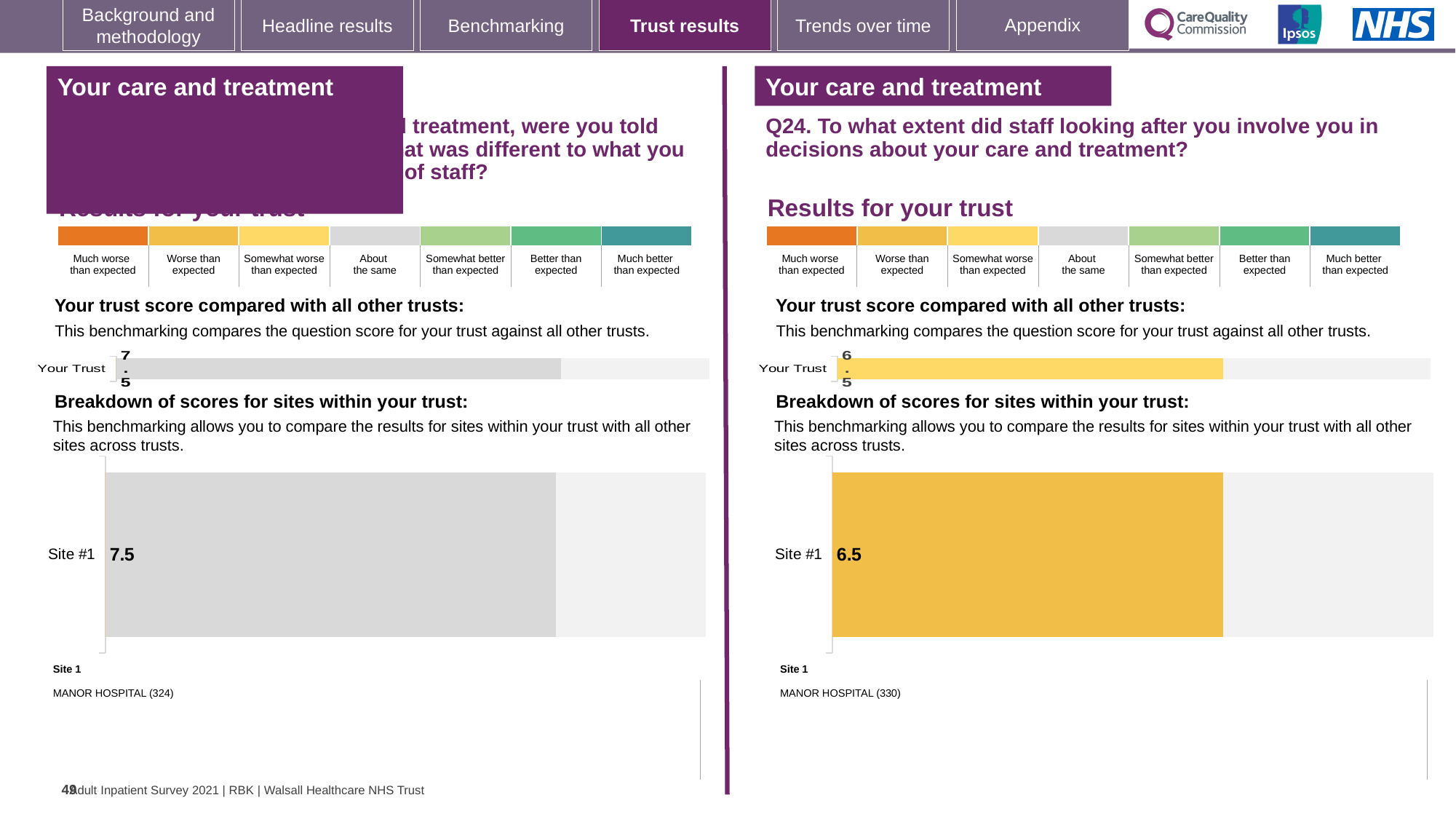
What kind of chart is used for the site breakdown on the left panel? bar chart On the right panel (Q24), which site is listed as Site 1? MANOR HOSPITAL (330) On the left panel, what is the score shown for Your Trust? 7.5 Which panel shows the higher Your Trust score, the left panel or the right panel (Q24)? the left panel On the right panel (Q24), what is the score shown for Your Trust? 6.5 On the right panel's (Q24) site breakdown chart, what is the score for Site #1? 6.5 On the left panel, which site is listed as Site 1? MANOR HOSPITAL (324) What is the difference between the Site #1 score on the left panel and the Site #1 score on the right panel (Q24)? 1.0 Is the Site #1 score on the right panel (Q24) greater or less than the Site #1 score on the left panel? less On the left panel's site breakdown chart, what is the score for Site #1? 7.5 How many sites are shown in the site breakdown chart on the right panel (Q24)? 1